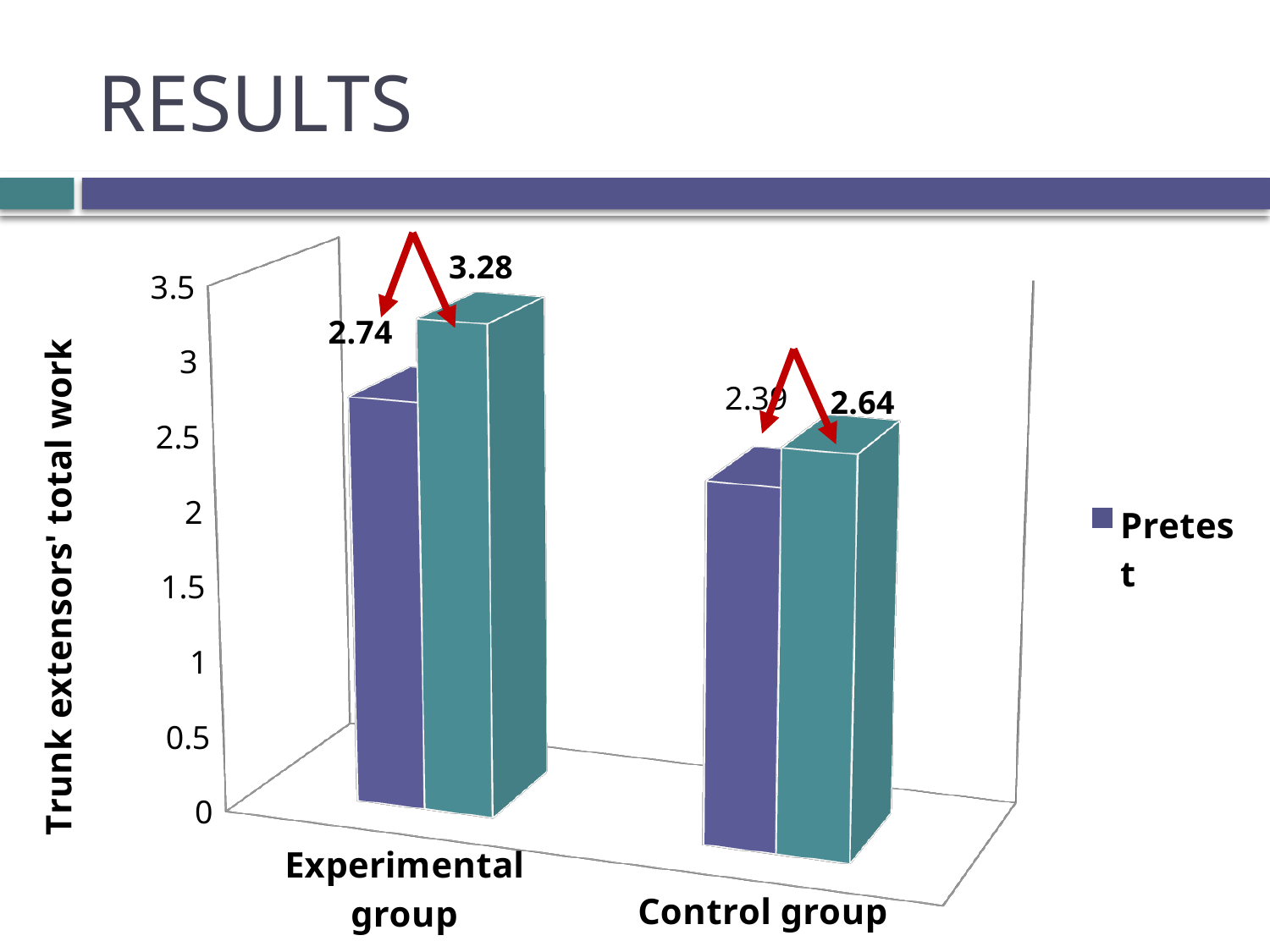
Which group has the higher Pretest bar? Experimental group Which is larger: the Experimental group's Pretest value or the Control group's teal bar value? Experimental group's Pretest value (2.74) What is the title of the vertical axis? Trunk extensors' total work What value is labelled on the teal bar for the Control group? 2.64 What is the difference between the teal bar values of the Experimental group (3.28) and the Control group (2.64)? 0.64 What is the difference between the teal bar (3.28) and the Pretest bar (2.74) for the Experimental group? 0.54 What kind of chart is shown on the slide? Bar chart Which bar on the chart has the highest value? The teal bar for the Experimental group (3.28) What value is labelled on the teal bar for the Experimental group? 3.28 How many groups are shown on the x axis of the chart? 2 Is the Pretest value for the Control group greater or less than 2.5? less What is the Pretest value for the Experimental group? 2.74